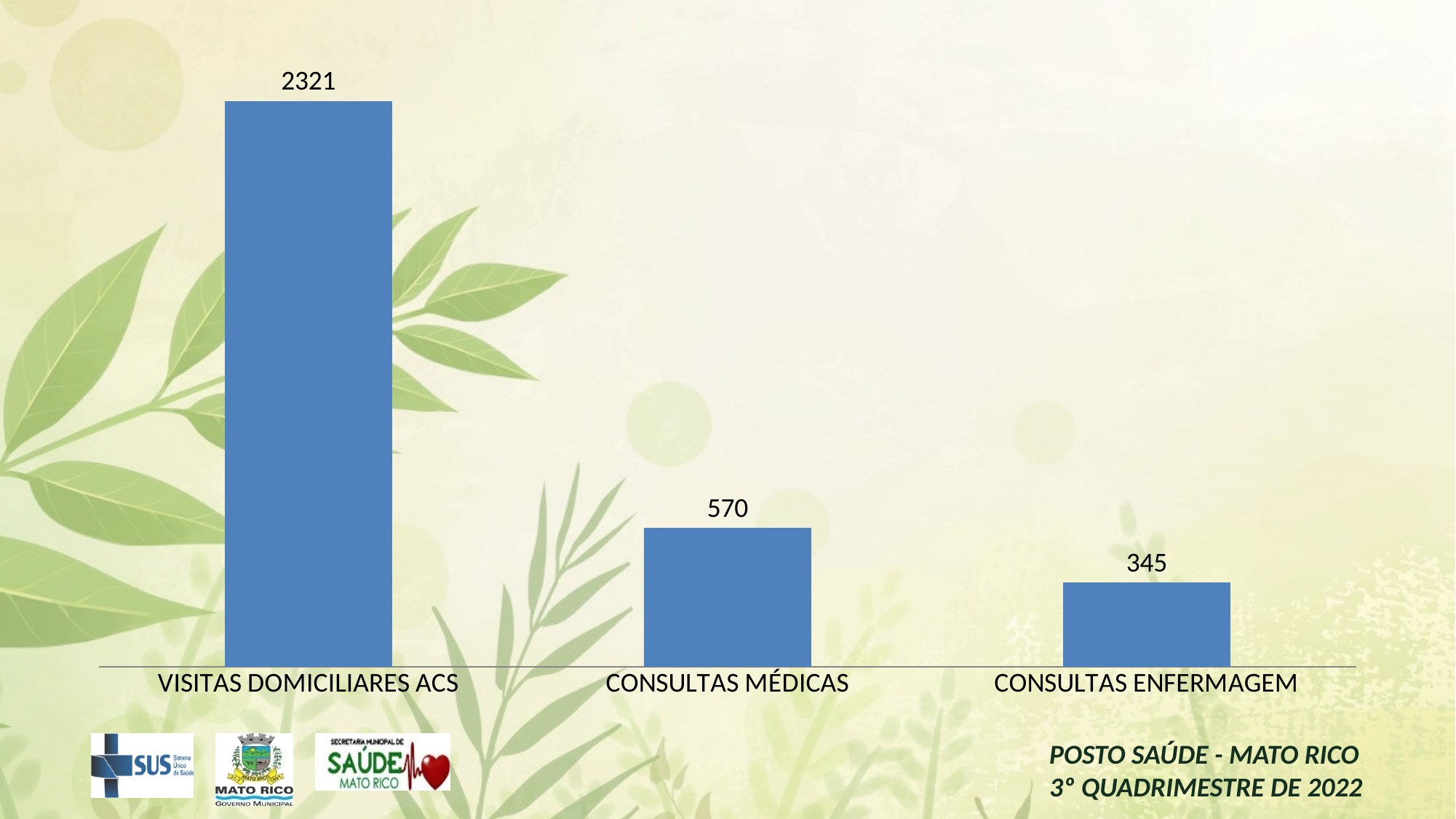
How many categories are shown in the chart? 3 What colour are the bars in the chart? Blue Which category has the lowest value? CONSULTAS ENFERMAGEM Which category has the highest value? VISITAS DOMICILIARES ACS What is the value for VISITAS DOMICILIARES ACS? 2321 Which is larger, the value for CONSULTAS MÉDICAS or the value for CONSULTAS ENFERMAGEM? CONSULTAS MÉDICAS What is the value for CONSULTAS MÉDICAS? 570 What kind of chart is shown on the slide? Bar chart What is the value for CONSULTAS ENFERMAGEM? 345 Do the values rise or fall from left to right across the categories? Fall What is the difference between the values for CONSULTAS MÉDICAS and CONSULTAS ENFERMAGEM? 225 What is the difference between the values for VISITAS DOMICILIARES ACS and CONSULTAS MÉDICAS? 1751